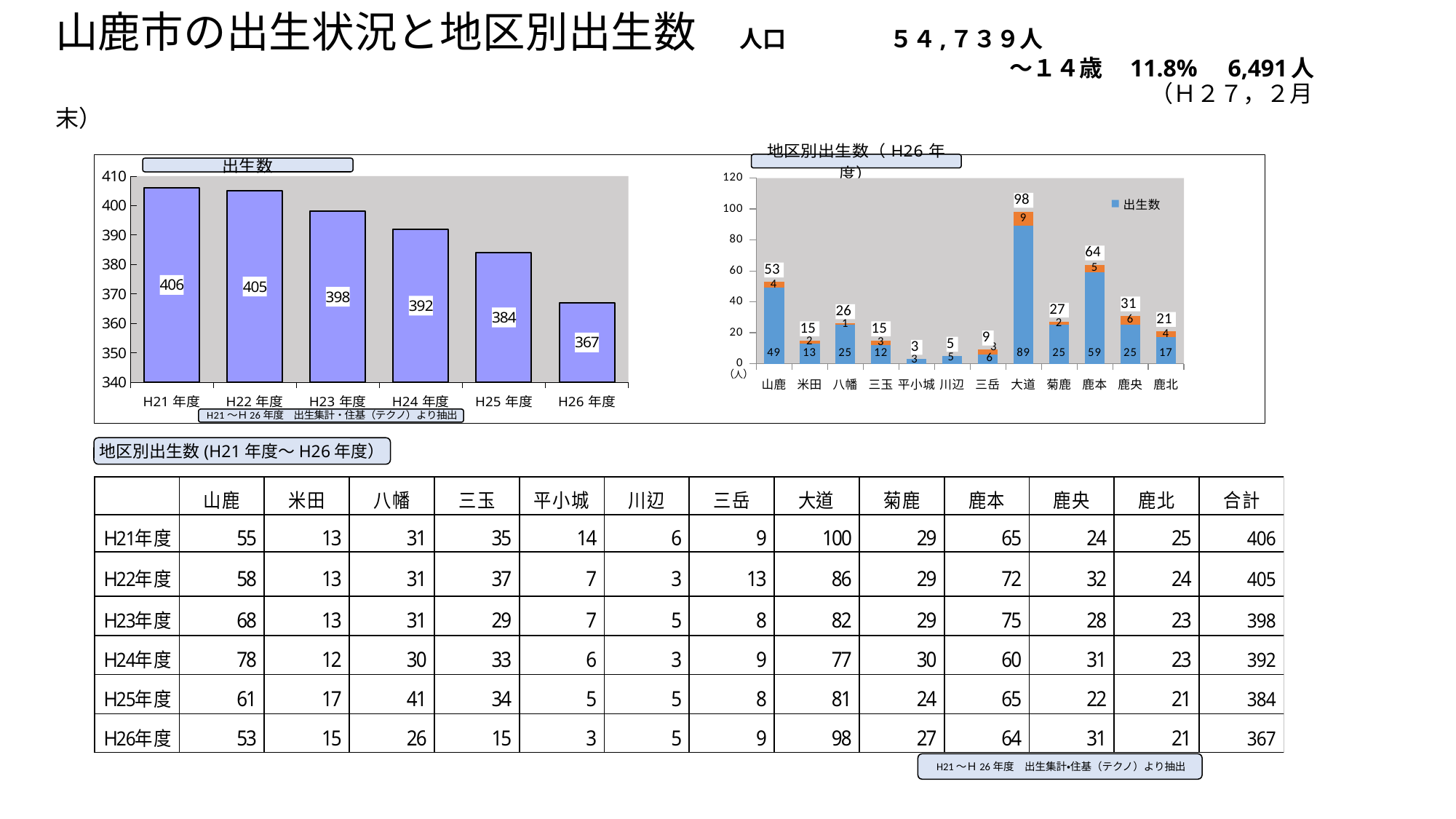
In the 出生数 chart on the left, what is the difference between the H21年度 and H26年度 values? 39 In the 出生数 chart on the left, which year has the lowest value? H26年度 In the 地区別出生数（H26年度） chart on the right, which district has the lowest total? 平小城 In the 出生数 chart on the left, do the values rise or fall from H21年度 to H26年度? fall In the 地区別出生数（H26年度） chart on the right, what is the value of the blue (bottom) segment for 鹿本? 59 In the 出生数 chart on the left, how many years are plotted? 6 In the 地区別出生数（H26年度） chart on the right, which district has the highest total? 大道 In the 地区別出生数（H26年度） chart on the right, which is larger, the total for 鹿央 or the total for 菊鹿? 鹿央 What kind of chart is the 出生数 chart on the left? bar chart In the 出生数 chart on the left, what is the value for H26年度? 367 In the 出生数 chart on the left, what is the value for H21年度? 406 In the 地区別出生数（H26年度） chart on the right, what is the total for 大道? 98